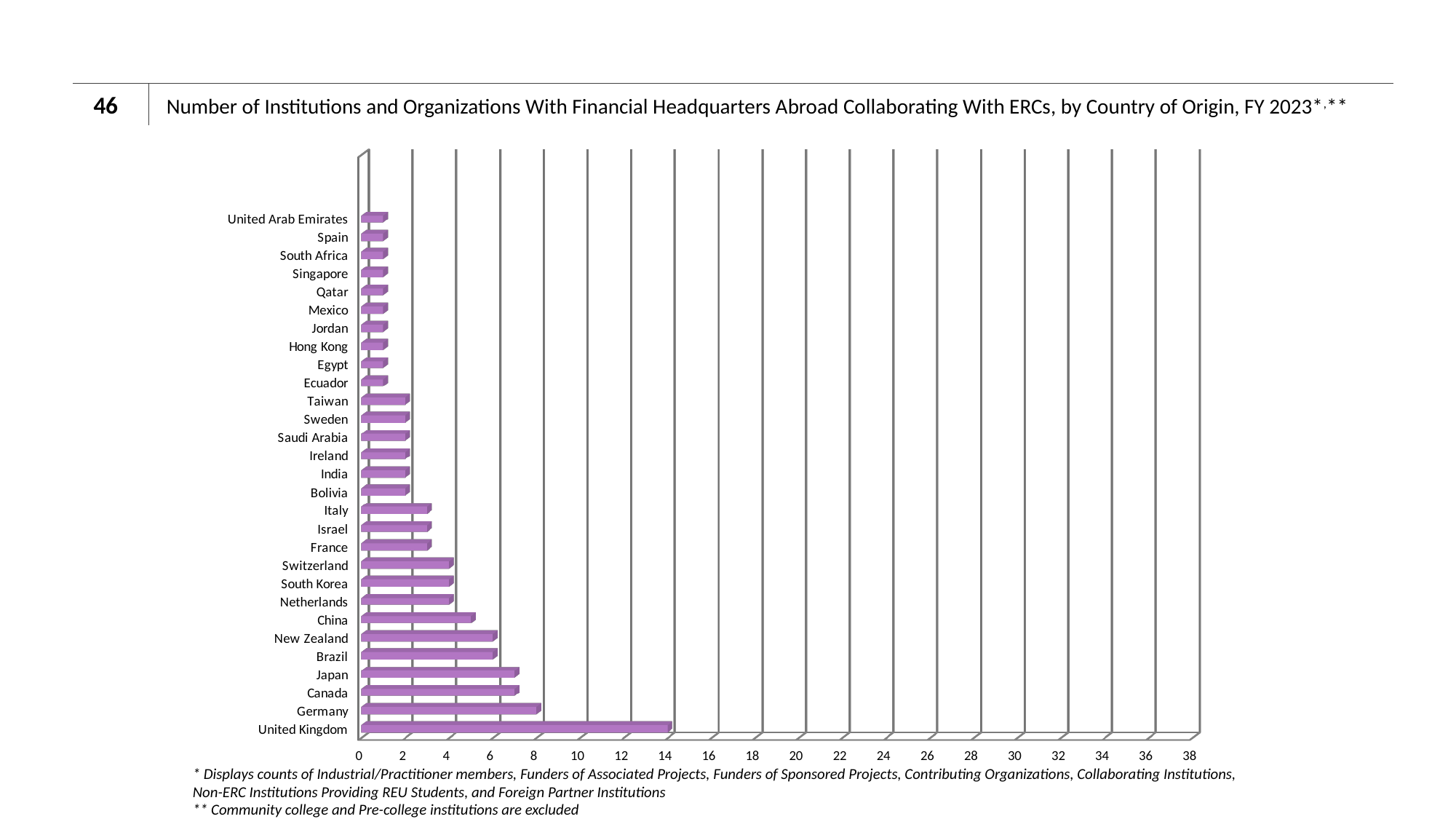
What is the highest value shown on the horizontal axis? 38 Is the value for China greater or less than 4? greater Which has a larger value, Spain or Brazil? Brazil Which has a larger value, Germany or China? Germany Which country has the highest number of institutions and organizations collaborating with ERCs? United Kingdom How many countries are listed on the chart? 29 What fiscal year does the chart title refer to? FY 2023 Is the value for Japan greater or less than 6? greater Is the value for Germany greater or less than 10? less What kind of chart is shown on the slide? bar chart